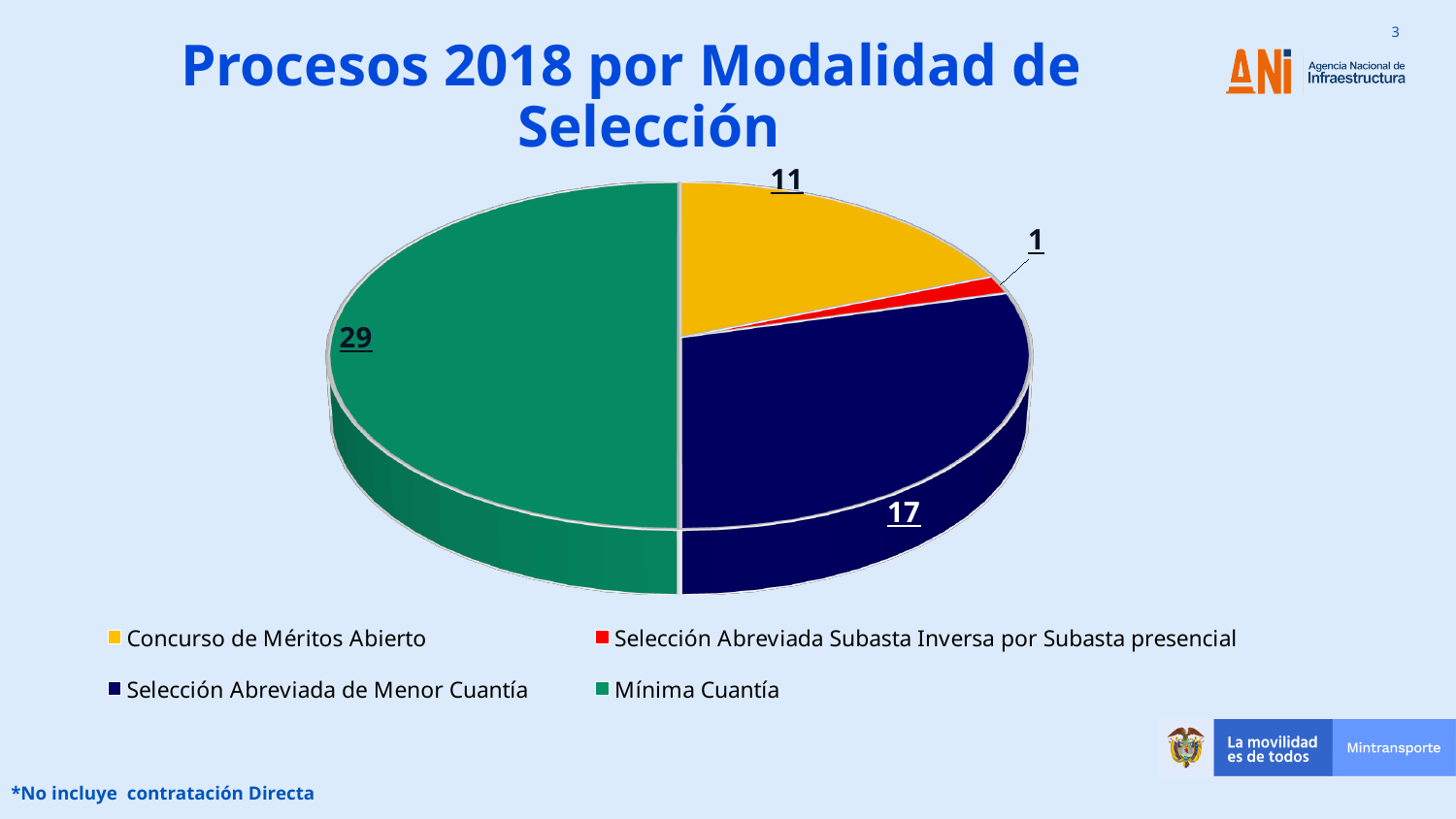
What is the value for Selección Abreviada de Menor Cuantía? 17 What is the difference between the values for Mínima Cuantía and Selección Abreviada de Menor Cuantía? 12 How many categories does the pie chart show? 4 What is the value for Selección Abreviada Subasta Inversa por Subasta presencial? 1 Which category has the smallest slice of the pie? Selección Abreviada Subasta Inversa por Subasta presencial Which is larger, the value for Concurso de Méritos Abierto or the value for Selección Abreviada de Menor Cuantía? Selección Abreviada de Menor Cuantía What kind of chart is shown on the slide? Pie chart What is the value for Concurso de Méritos Abierto? 11 What share of the total does Mínima Cuantía represent? 50% Which category has the largest slice of the pie? Mínima Cuantía What is the title of the chart? Procesos 2018 por Modalidad de Selección What is the value for Mínima Cuantía? 29